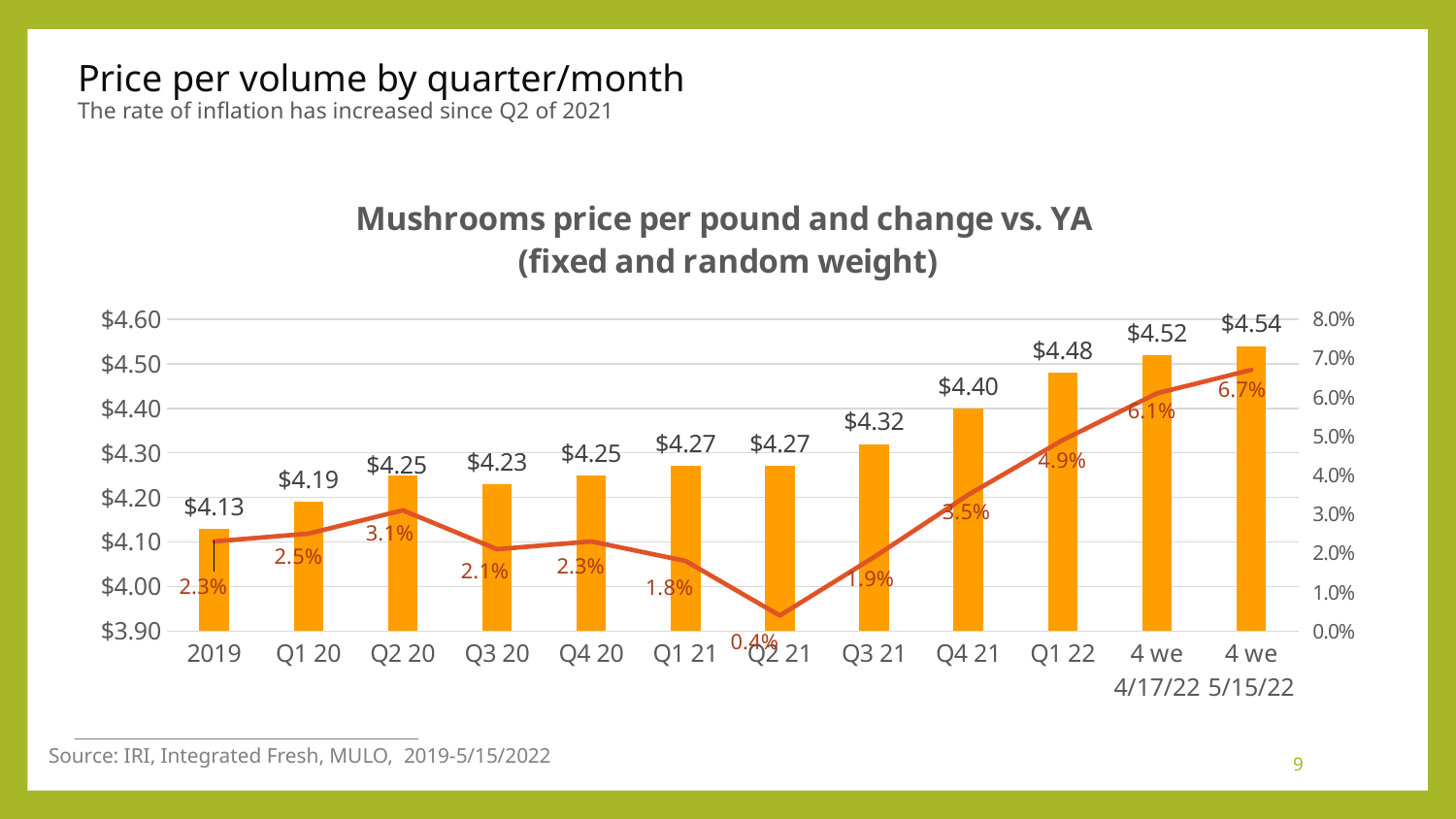
Which period has the lowest change vs. YA on the line? Q2 21 Which is larger, the price per pound in Q3 20 or in Q4 20? Q4 20 What is the difference in price per pound between Q1 22 and 2019? $0.35 How many periods are shown on the x axis? 12 What is the title of the chart? Mushrooms price per pound and change vs. YA (fixed and random weight) What is the change vs. YA shown for Q2 20? 3.1% Does the change vs. YA line rise or fall from Q2 21 to 4 we 5/15/22? Rise What is the price per pound for the 4 weeks ending 5/15/22? $4.54 What is the change vs. YA for the 4 weeks ending 4/17/22? 6.1% What kind of chart is used to show the price per pound values? Bar chart Which period has the highest price per pound? 4 we 5/15/22 What is the mushroom price per pound for Q4 21? $4.40